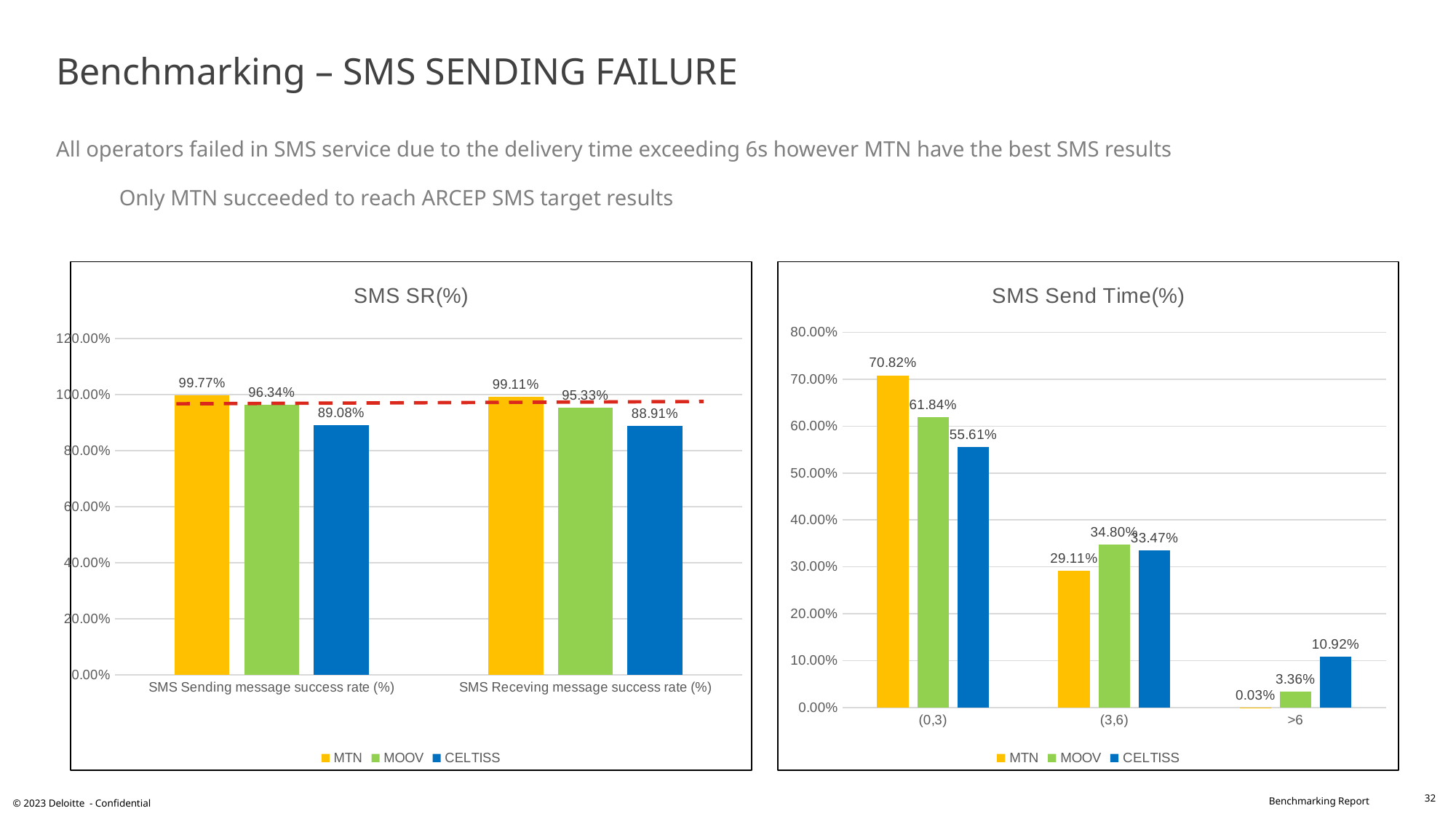
In the SMS Send Time(%) chart, which operator has the highest value in the (0,3) category? MTN In the SMS Send Time(%) chart, is the value for MOOV in the >6 category larger or smaller than the value for MTN in the same category? Larger In the SMS Send Time(%) chart, what is the value for CELTISS in the >6 category? 10.92% In the SMS Send Time(%) chart, what is the value for MOOV in the (3,6) category? 34.80% In the SMS SR(%) chart, how many series does the legend list? 3 In the SMS SR(%) chart, what is the value for CELTISS for SMS Receving message success rate (%)? 88.91% In the SMS Send Time(%) chart, how many categories are shown on the x axis? 3 In the SMS Send Time(%) chart, what is the difference between MTN and CELTISS in the (0,3) category? 15.21% In the SMS SR(%) chart, what is the value for MTN for SMS Sending message success rate (%)? 99.77% In the SMS SR(%) chart, what is the difference between MTN and CELTISS for SMS Sending message success rate (%)? 10.69% In the SMS SR(%) chart, which operator has the lowest SMS Sending message success rate (%)? CELTISS What kind of chart is the SMS Send Time(%) chart? Bar chart